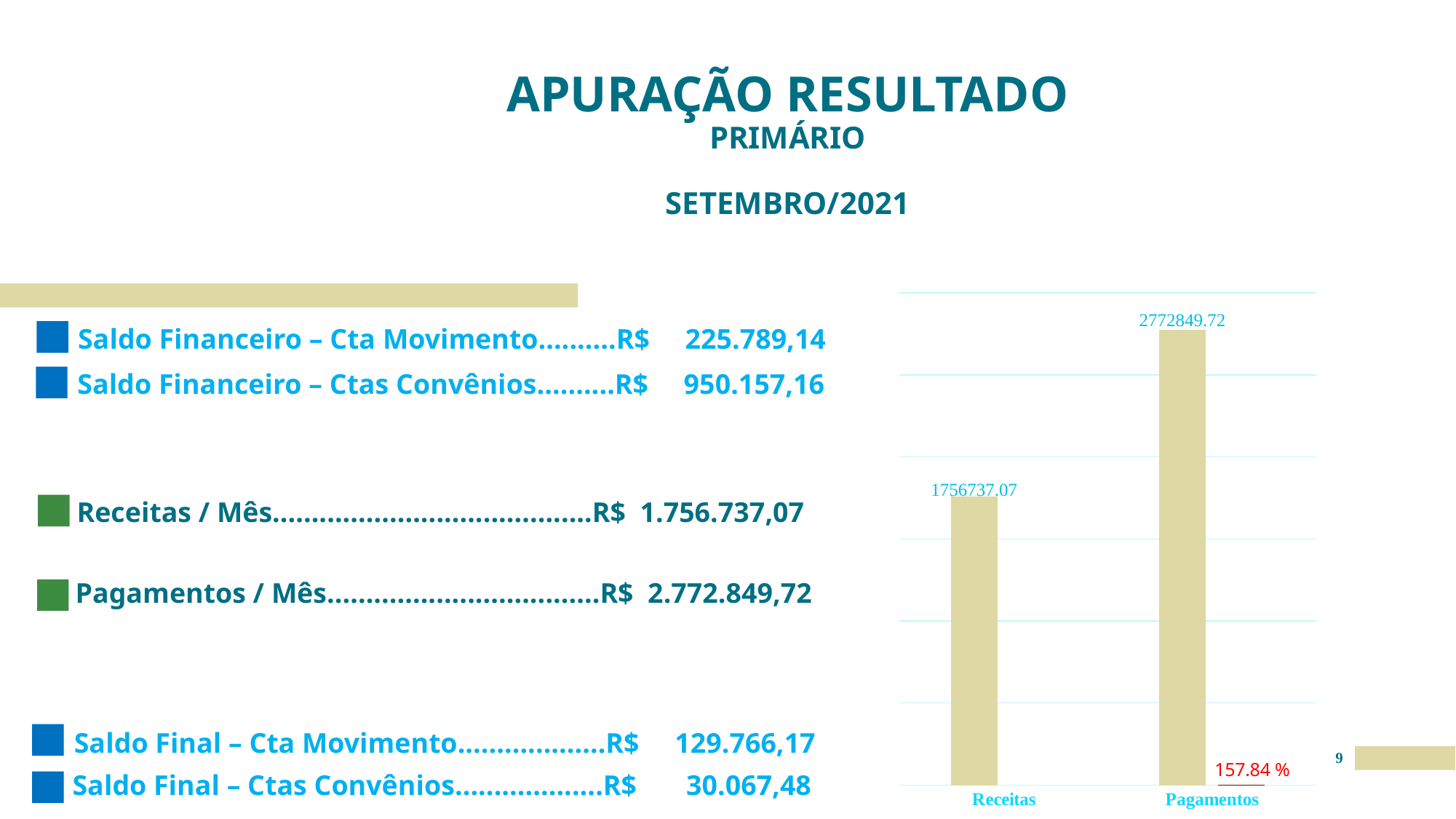
What percentage is printed in red near the bottom of the Pagamentos bar? 157.84 % How many bars are plotted in the chart? 2 Which category has the highest bar in the chart? Pagamentos What is the value of the Receitas bar in the chart? 1756737.07 Do the bar values rise or fall from Receitas to Pagamentos? Rise What is the value of the Pagamentos bar in the chart? 2772849.72 Which category has the lowest bar in the chart? Receitas Which is larger in the chart, Receitas or Pagamentos? Pagamentos What are the category labels on the x axis of the chart? Receitas, Pagamentos What is the difference between the Pagamentos and Receitas values in the chart? 1016112.65 What kind of chart is shown on the slide? Bar chart